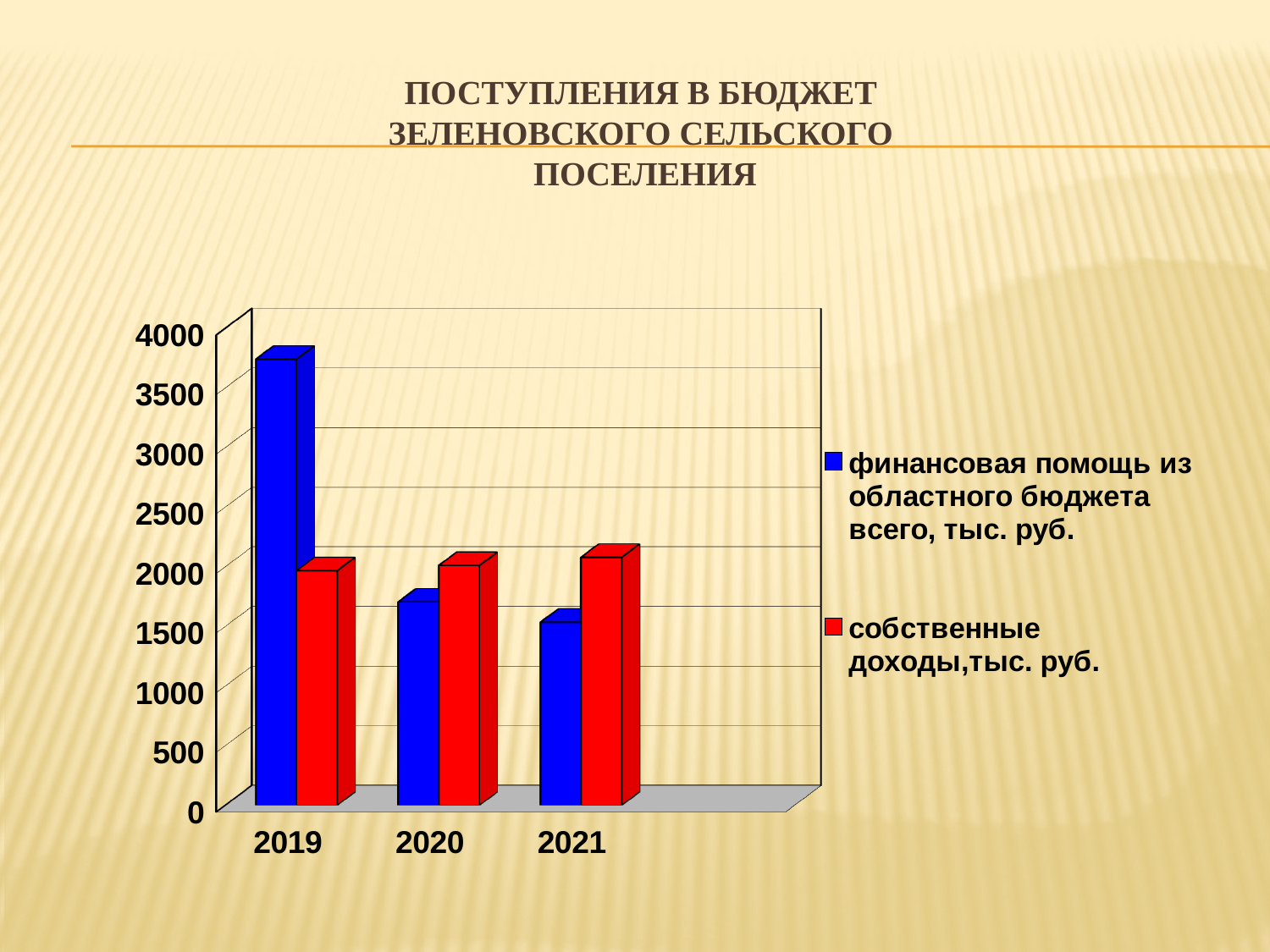
Is the value for "финансовая помощь из областного бюджета всего, тыс. руб." in 2020 greater or less than 2000? less Do the values for "финансовая помощь из областного бюджета всего, тыс. руб." rise or fall from 2019 to 2021? fall Is the value for "финансовая помощь из областного бюджета всего, тыс. руб." in 2019 greater or less than 3500? greater What kind of chart is shown on the slide? bar chart What colour are the bars for "собственные доходы,тыс. руб."? red In which year is the value for "финансовая помощь из областного бюджета всего, тыс. руб." the lowest? 2021 In 2021, which series has the larger value: "финансовая помощь из областного бюджета всего, тыс. руб." or "собственные доходы,тыс. руб."? собственные доходы,тыс. руб. Is the value for "собственные доходы,тыс. руб." in 2021 greater or less than 1500? greater In which year is the value for "финансовая помощь из областного бюджета всего, тыс. руб." the highest? 2019 In 2019, which series has the larger value: "финансовая помощь из областного бюджета всего, тыс. руб." or "собственные доходы,тыс. руб."? финансовая помощь из областного бюджета всего, тыс. руб. How many series does the chart legend list? 2 How many years are shown on the x axis of the chart? 3